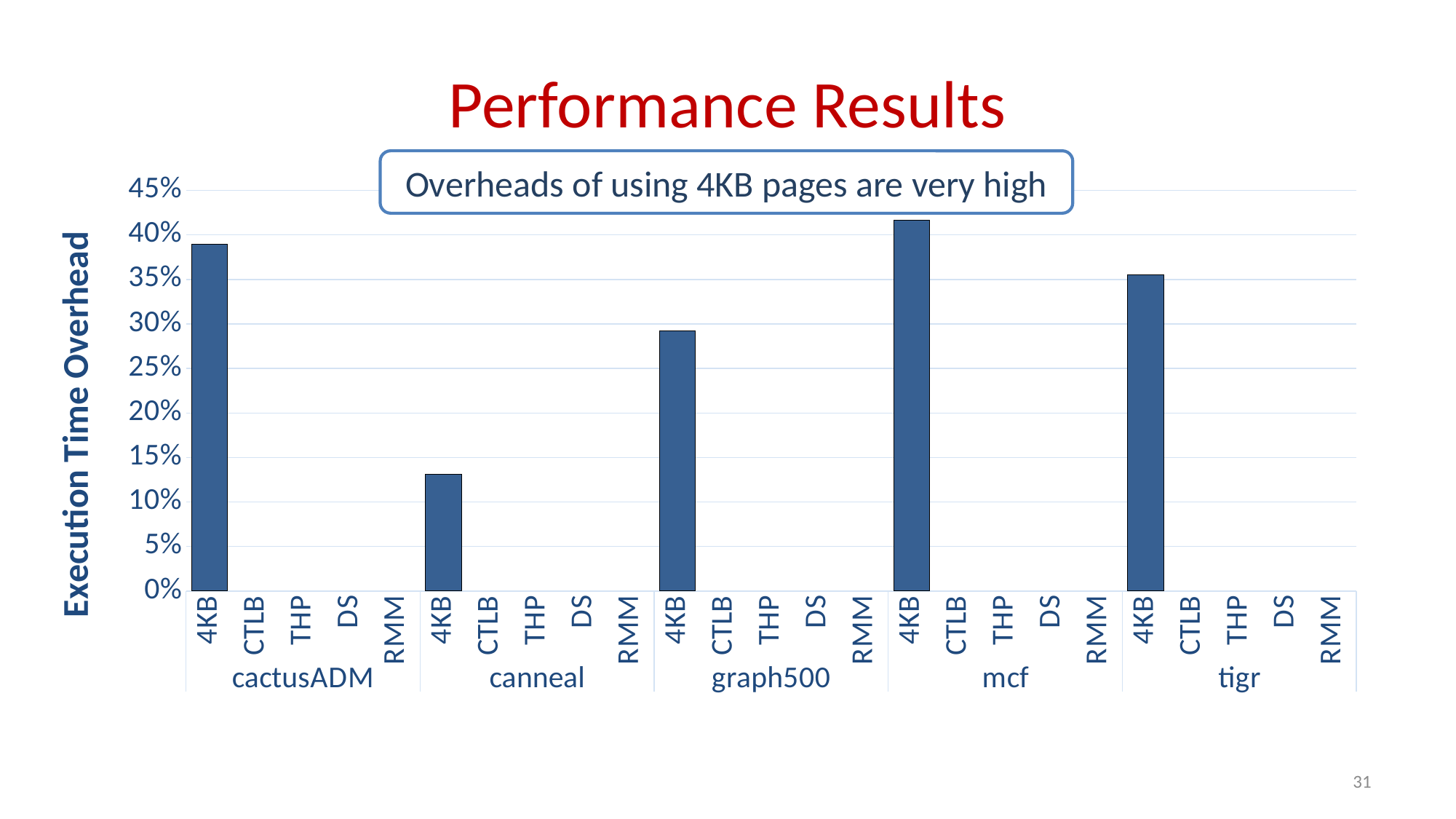
Is the 4KB execution time overhead for canneal greater or less than 15%? less Which has a larger 4KB execution time overhead, graph500 or tigr? tigr Is the 4KB execution time overhead for mcf greater or less than 40%? greater What is the label of the vertical axis? Execution Time Overhead Is the 4KB execution time overhead for cactusADM greater or less than 35%? greater Which benchmark has the highest 4KB execution time overhead? mcf Which has a larger 4KB execution time overhead, cactusADM or canneal? cactusADM What kind of chart is shown on the slide? bar chart Which benchmark has the lowest 4KB execution time overhead? canneal How many benchmark groups are shown along the x axis? 5